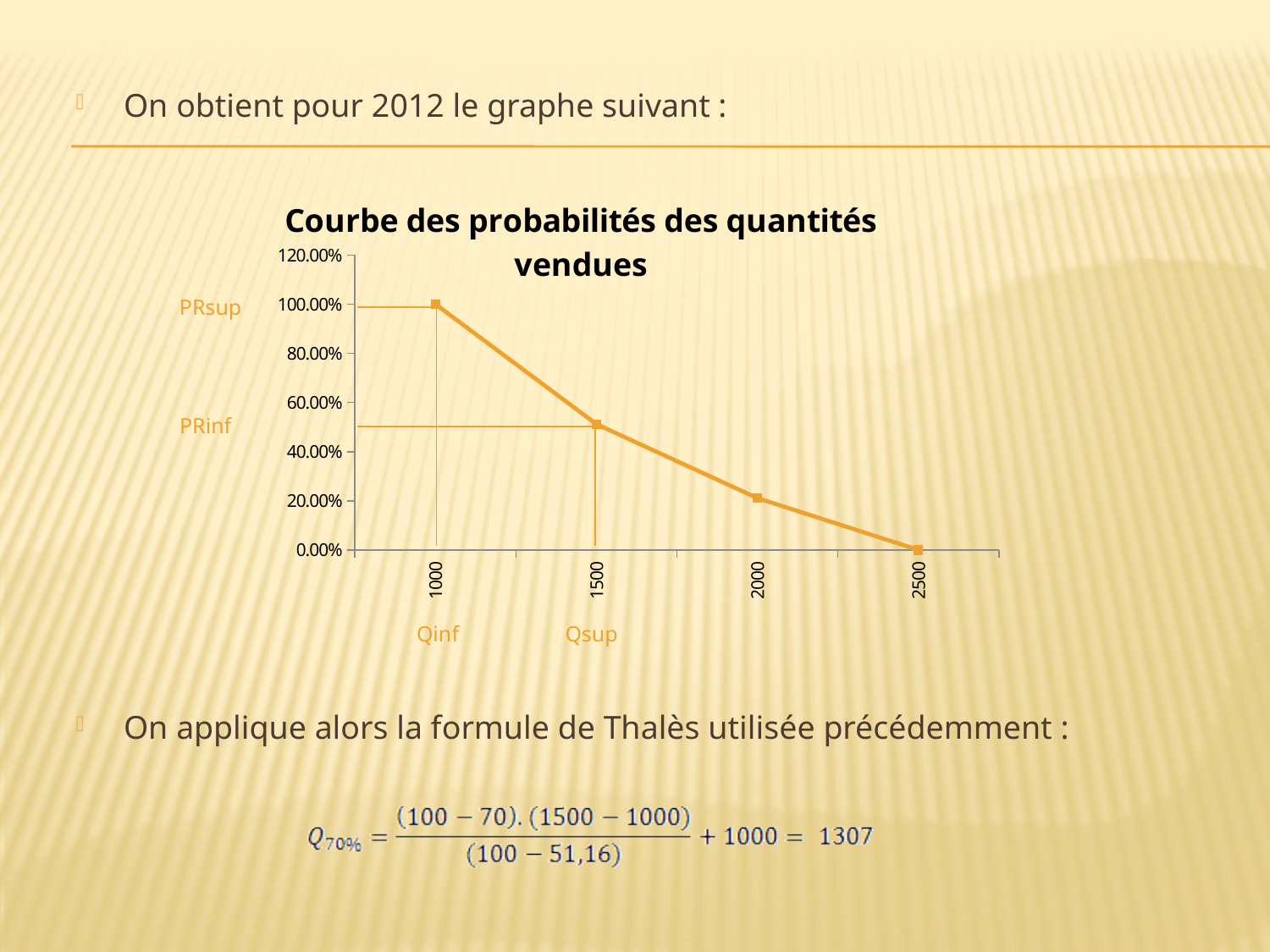
What is the title of the chart? Courbe des probabilités des quantités vendues Which quantity has the highest probability value? 1000 Do the values rise or fall as the quantity increases along the x axis? fall Is the value for the quantity 2000 greater or less than 40.00%? less Is the value for the quantity 1500 greater or less than 40.00%? greater Which quantity has the lowest probability value? 2500 What kind of chart is shown on the slide? line chart How many data points are plotted on the line? 4 What is the probability value plotted for the quantity 1000? 100.00% What is the probability value plotted for the quantity 2500? 0.00% Which x-axis quantity is labelled Qsup below the chart? 1500 Which has the larger probability value, the quantity 1500 or the quantity 2000? 1500